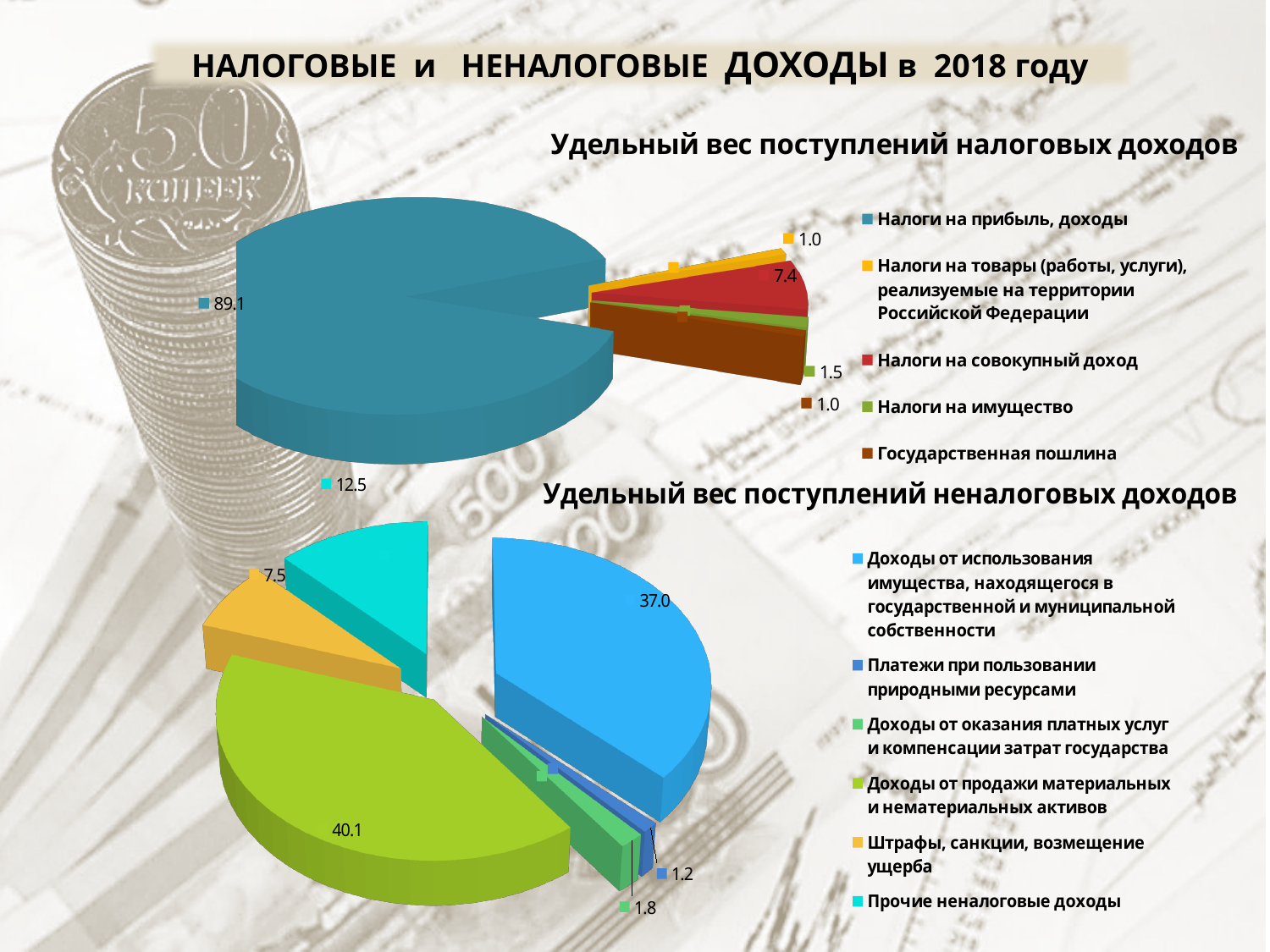
On the chart 'Удельный вес поступлений налоговых доходов', which category has the largest share? Налоги на прибыль, доходы On the chart 'Удельный вес поступлений неналоговых доходов', what is the value for 'Доходы от продажи материальных и нематериальных активов'? 40.1 On the chart 'Удельный вес поступлений неналоговых доходов', which category has the smallest share? Платежи при пользовании природными ресурсами On the chart 'Удельный вес поступлений неналоговых доходов', which is larger: 'Штрафы, санкции, возмещение ущерба' or 'Прочие неналоговые доходы'? Прочие неналоговые доходы On the chart 'Удельный вес поступлений налоговых доходов', what is the value for 'Налоги на прибыль, доходы'? 89.1 On the chart 'Удельный вес поступлений неналоговых доходов', what is the difference between the values for 'Доходы от продажи материальных и нематериальных активов' and 'Доходы от использования имущества, находящегося в государственной и муниципальной собственности'? 3.1 On the chart 'Удельный вес поступлений неналоговых доходов', what is the value for 'Платежи при пользовании природными ресурсами'? 1.2 On the chart 'Удельный вес поступлений налоговых доходов', how many categories does the legend list? 5 On the chart 'Удельный вес поступлений налоговых доходов', what is the value for 'Налоги на имущество'? 1.5 What type of chart is used for 'Удельный вес поступлений неналоговых доходов'? Pie chart On the chart 'Удельный вес поступлений неналоговых доходов', what is the value for 'Прочие неналоговые доходы'? 12.5 On the chart 'Удельный вес поступлений налоговых доходов', what is the value for 'Налоги на совокупный доход'? 7.4